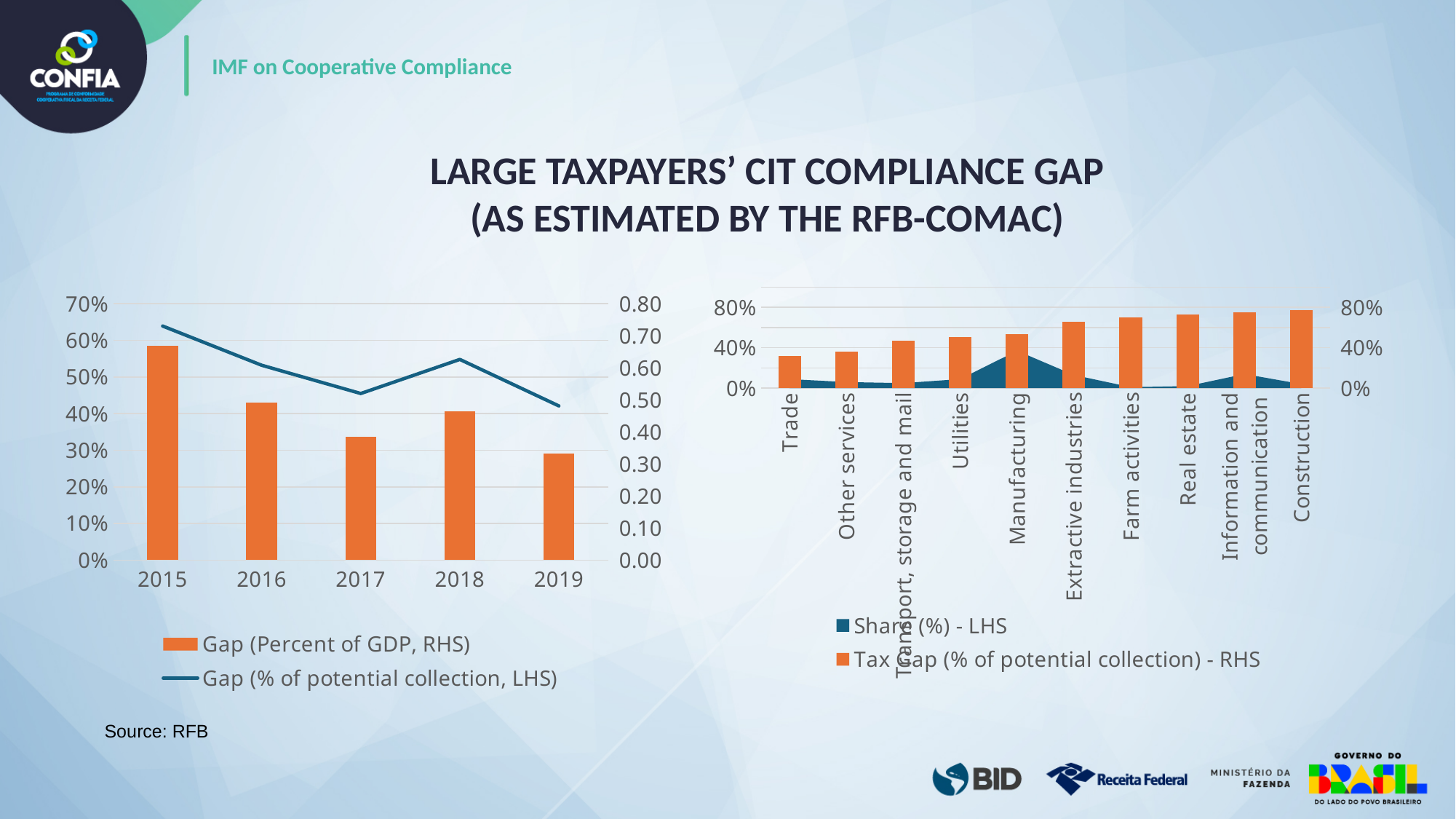
On the left chart, is the Gap (% of potential collection, LHS) line value for 2019 greater or less than 60%? less On the right chart, which sector has the highest Tax Gap (% of potential collection) bar? Construction How many series does the legend of the left chart list? 2 On the left chart, in which year does the Gap (% of potential collection, LHS) line reach its highest point? 2015 On the right chart, do the Tax Gap (% of potential collection) bars rise or fall from left to right across the sectors? rise On the left chart, which year has the tallest bar for Gap (Percent of GDP, RHS)? 2015 On the left chart, is the bar for 2015 taller or shorter than the bar for 2017? taller How many years are shown on the x axis of the left chart? 5 On the right chart, which sector has the lowest Tax Gap (% of potential collection) bar? Trade On the left chart, which year has the shortest bar for Gap (Percent of GDP, RHS)? 2019 On the left chart, is the Gap (% of potential collection, LHS) line value for 2015 greater or less than 60%? greater